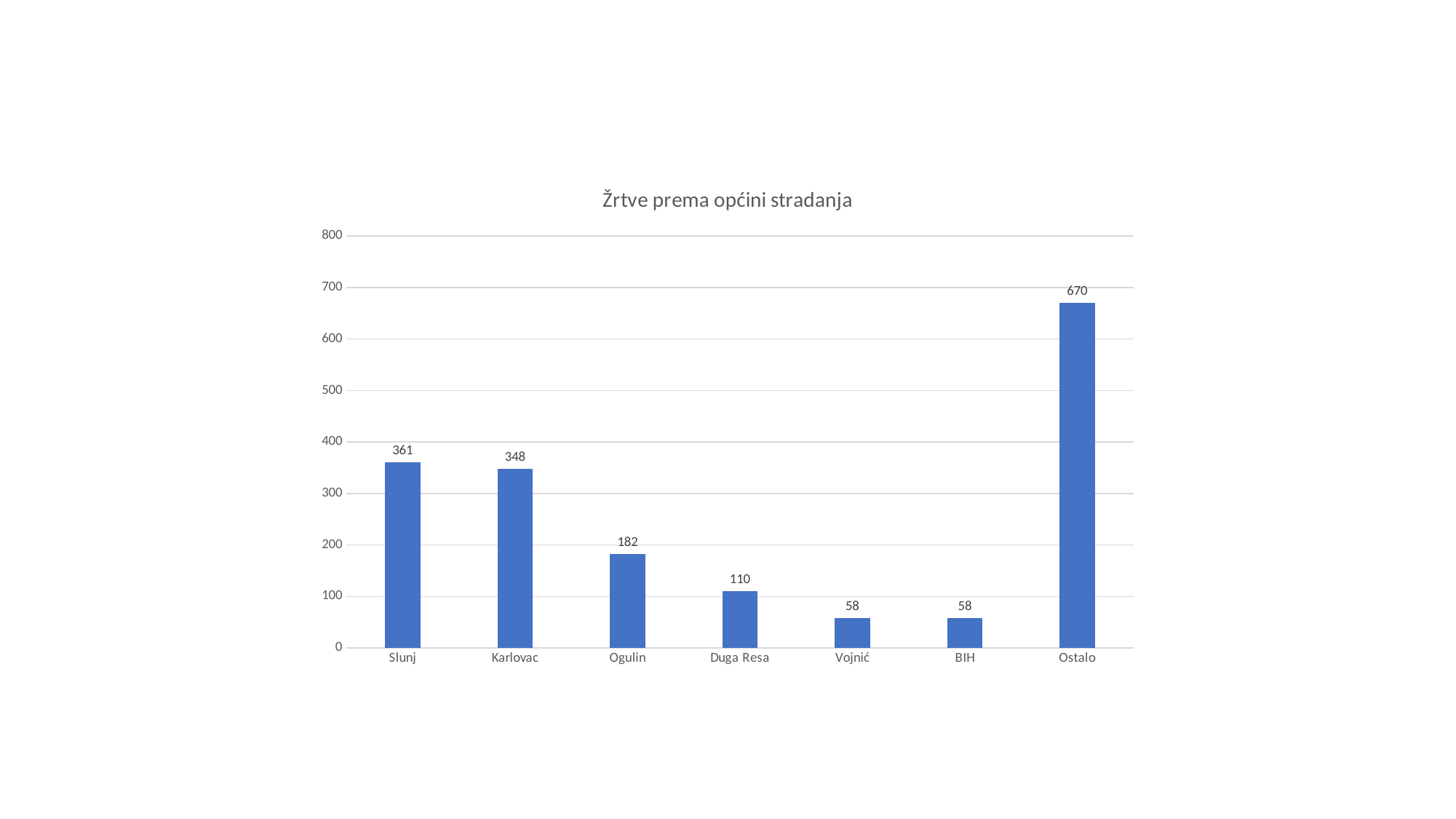
Is the value for Ostalo greater or less than 600? greater Which two categories share the same value of 58? Vojnić and BIH What is the title of the chart? Žrtve prema općini stradanja Which is larger, the value for Karlovac or the value for Ogulin? Karlovac What is the value for Duga Resa? 110 What is the value for Ogulin? 182 What is the difference between the values for Ostalo and Ogulin? 488 How many categories are shown on the x axis? 7 What kind of chart is shown on the slide? Bar chart What is the value for Slunj? 361 Which category has the highest value? Ostalo What is the difference between the values for Slunj and Karlovac? 13